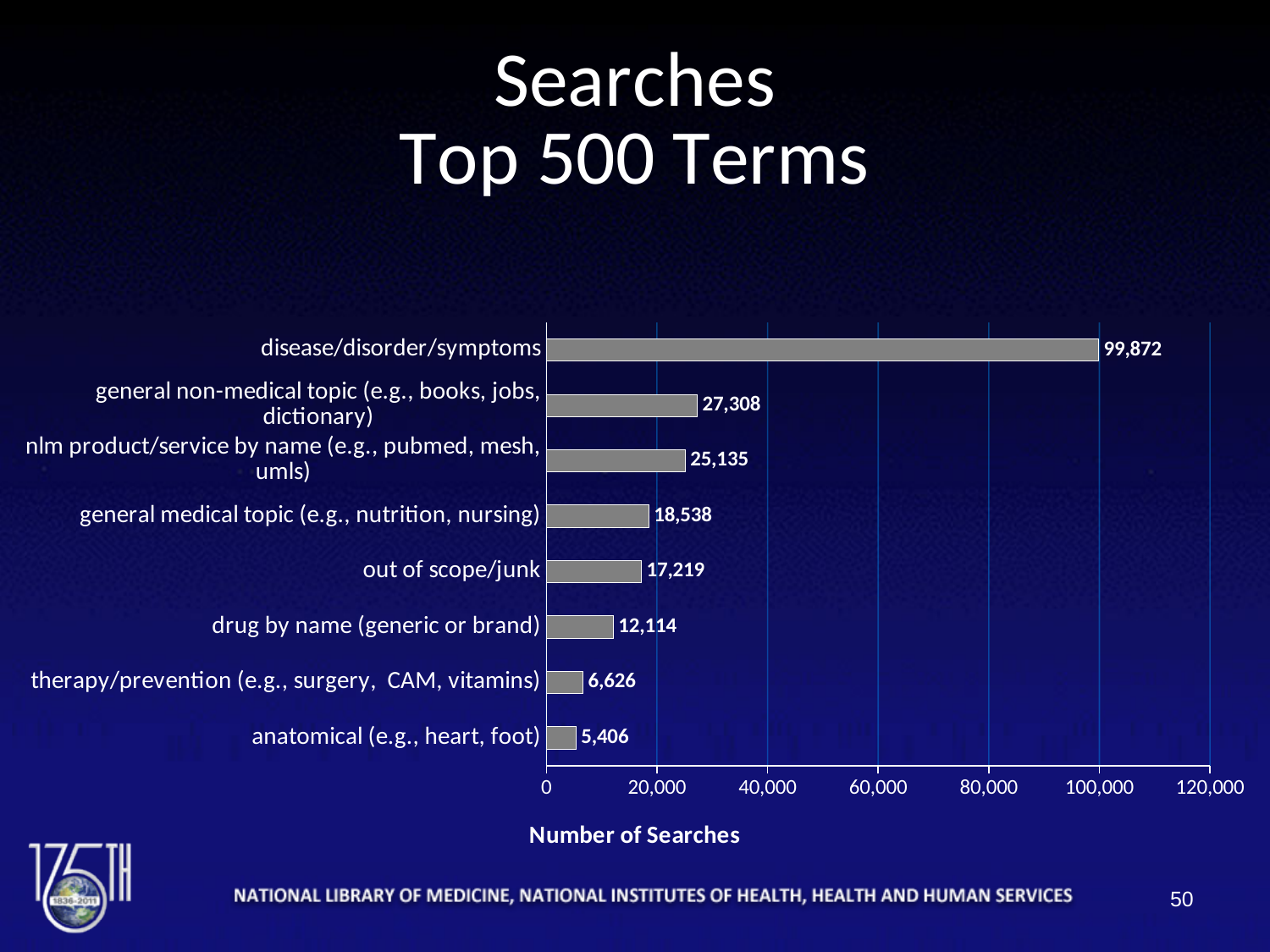
How many categories are shown in the chart? 8 Is the number of searches for general non-medical topic greater or less than 20,000? greater What is the number of searches for drug by name (generic or brand)? 12,114 What is the difference in number of searches between therapy/prevention and anatomical? 1,220 What is the number of searches for out of scope/junk? 17,219 What type of chart is shown on the slide? bar chart Which category has the highest number of searches? disease/disorder/symptoms Which category has the lowest number of searches? anatomical (e.g., heart, foot) What is the label of the horizontal axis? Number of Searches What is the number of searches for disease/disorder/symptoms? 99,872 Which has more searches: general medical topic or out of scope/junk? general medical topic (e.g., nutrition, nursing) What is the difference in number of searches between general non-medical topic and nlm product/service by name? 2,173